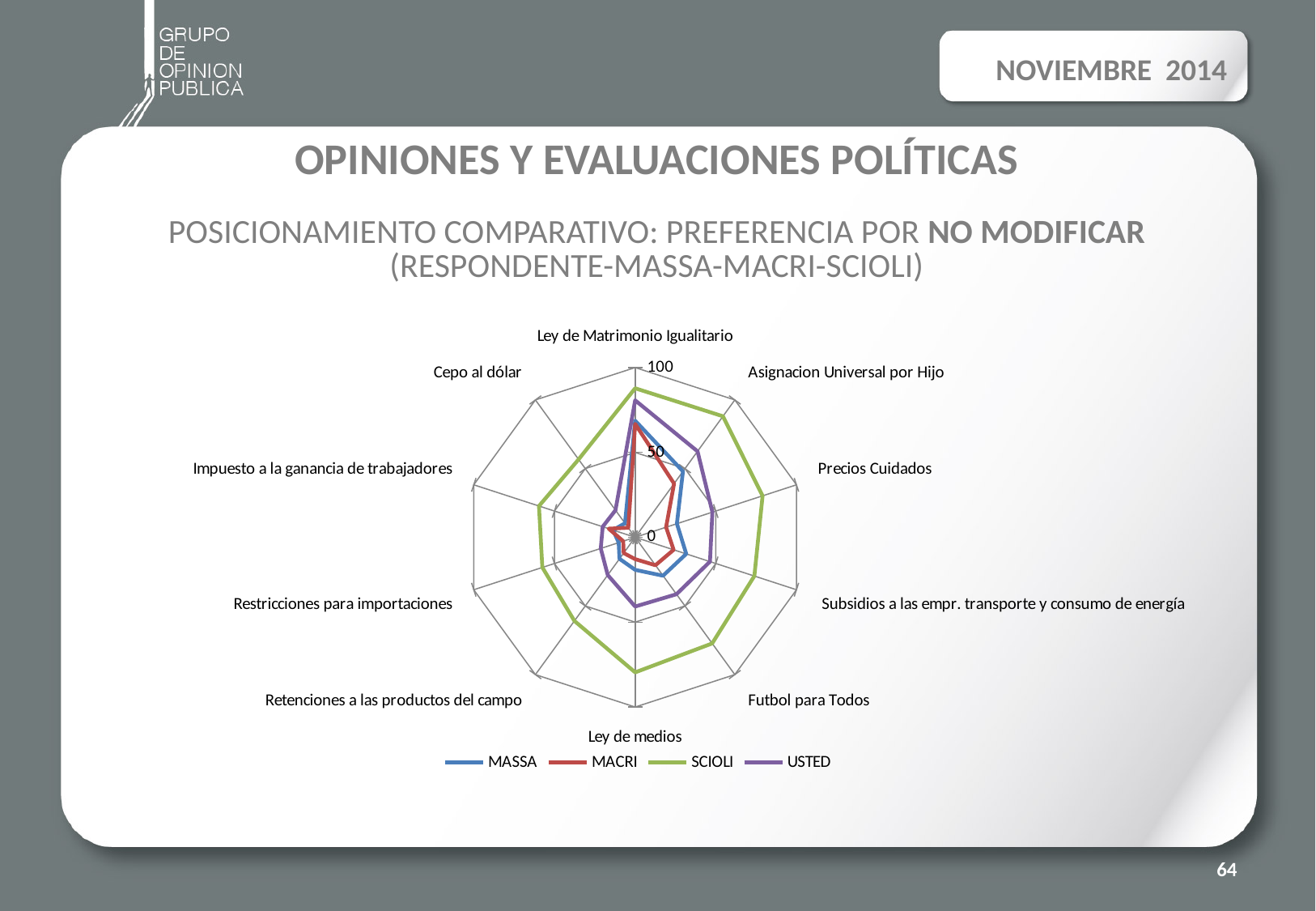
Is the MASSA value for Retenciones a las productos del campo greater or less than 50? less Which series has the highest value for Ley de medios? SCIOLI Is the USTED value for Asignacion Universal por Hijo greater or less than 50? greater Is the MACRI value for Impuesto a la ganancia de trabajadores greater or less than 50? less What kind of chart is shown on the slide? radar chart Which colour represents the SCIOLI series? green Which series are listed in the legend? MASSA, MACRI, SCIOLI, USTED For Ley de medios, which series has the higher value, SCIOLI or MACRI? SCIOLI How many series does the legend list? 4 How many categories (axes) does the radar chart have? 10